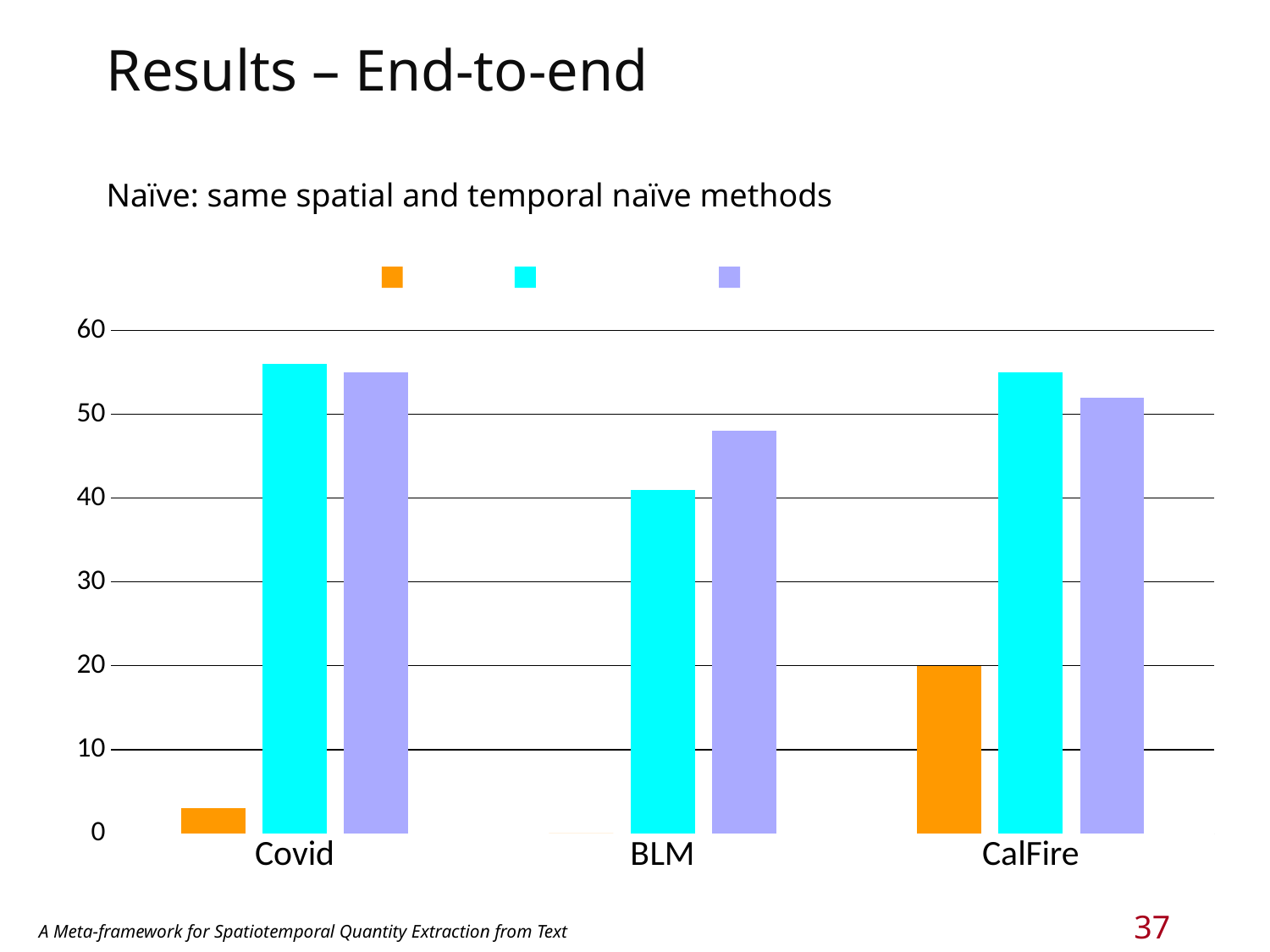
How many series does the chart's legend list? 3 Is the value of the cyan bar for BLM greater or less than 50? less For BLM, which is larger: the cyan bar or the purple bar? purple bar What are the three category labels on the x axis of the chart? Covid, BLM, CalFire Is the value of the purple bar for BLM greater or less than 40? greater What kind of chart is shown on the slide? bar chart Is the value of the cyan bar for Covid greater or less than 50? greater What is the value of the orange bar for CalFire? 20 Which category has the lowest cyan bar? BLM How many categories are shown on the x axis of the chart? 3 Which category has the highest orange bar? CalFire